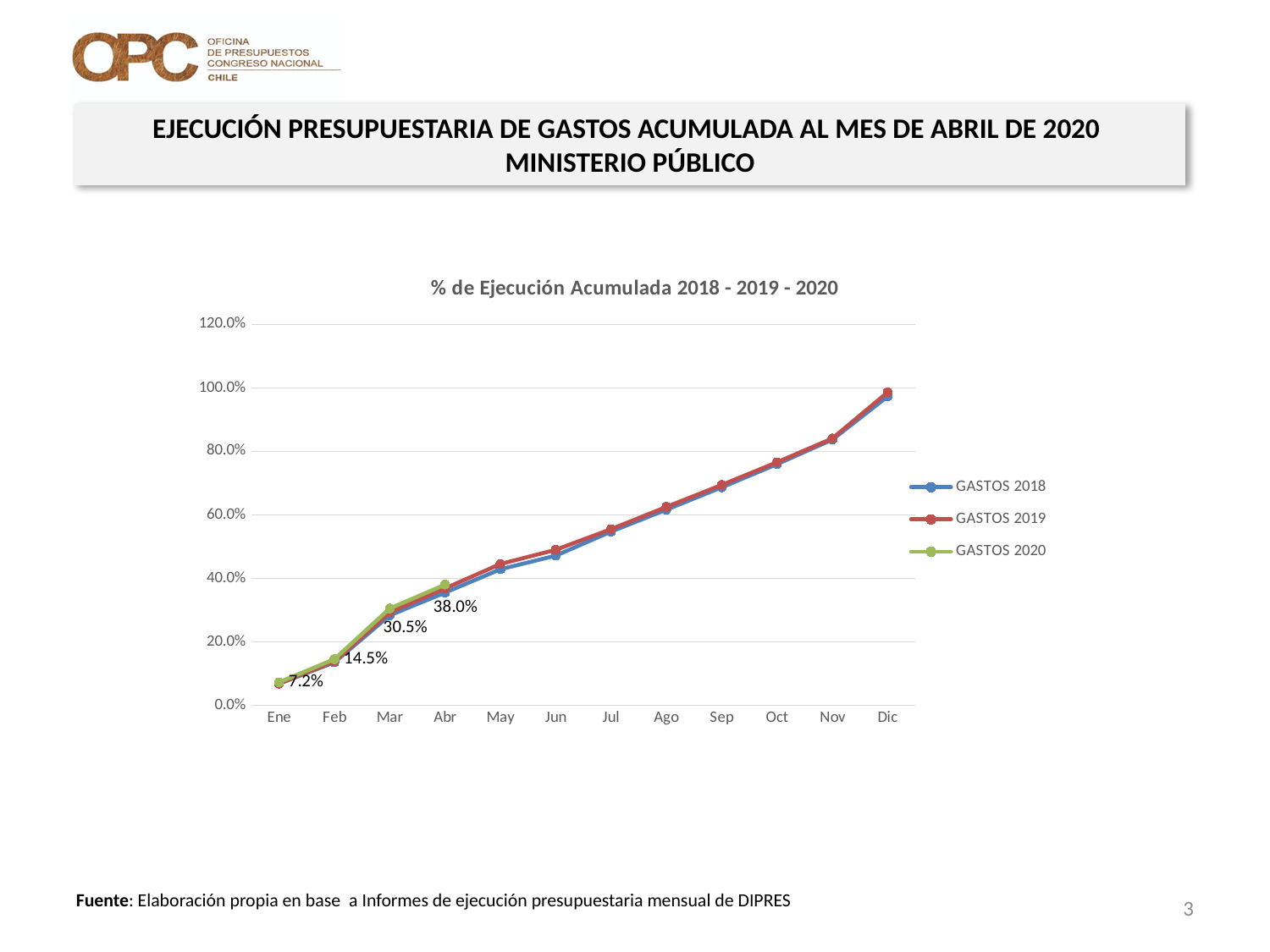
What is the value for GASTOS 2020 in Mar? 30.5% Is the value for GASTOS 2018 in Jun greater or less than 60.0%? less How many months are shown on the x axis? 12 What is the value for GASTOS 2020 in Feb? 14.5% Do the values for GASTOS 2019 rise or fall from Ene to Dic? rise How many series does the legend list? 3 What is the difference between the GASTOS 2020 values for Abr and Mar? 7.5% Is the value for GASTOS 2019 in Dic greater or less than 80.0%? greater What is the value for GASTOS 2020 in Ene? 7.2% What is the title of the chart? % de Ejecución Acumulada 2018 - 2019 - 2020 What is the value for GASTOS 2020 in Abr? 38.0% What kind of chart is shown on the slide? line chart